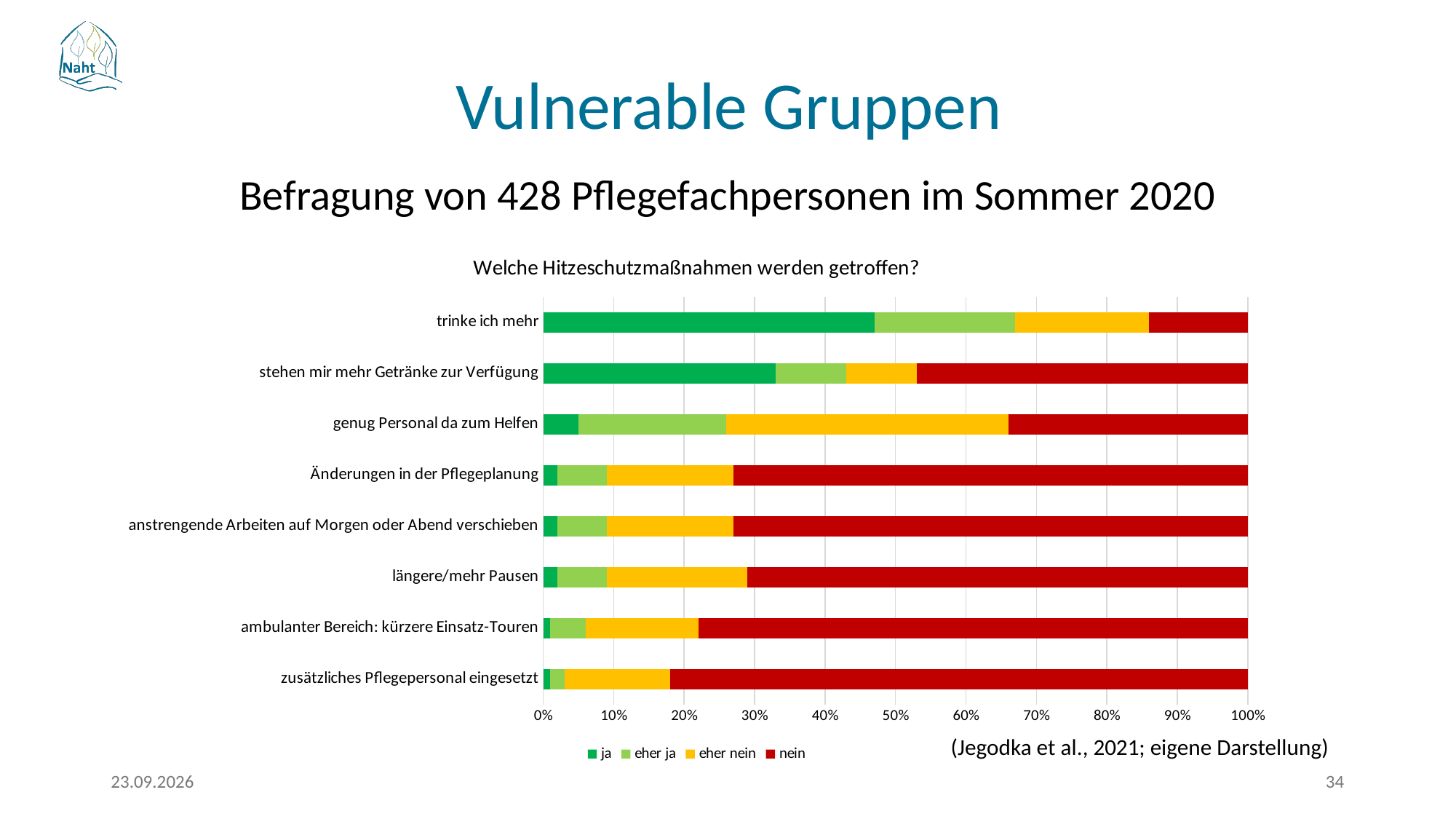
Which measure has the smallest 'nein' share? trinke ich mehr Is the 'ja' share for 'genug Personal da zum Helfen' greater or less than 10%? less Which has the larger 'nein' share: 'genug Personal da zum Helfen' or 'Änderungen in der Pflegeplanung'? Änderungen in der Pflegeplanung Which measure has the largest 'ja' share? trinke ich mehr What is the title of the chart? Welche Hitzeschutzmaßnahmen werden getroffen? What kind of chart is shown on the slide? bar chart How many measures (categories) are listed on the vertical axis of the chart? 8 Is the 'nein' share for 'zusätzliches Pflegepersonal eingesetzt' greater or less than 70%? greater Which entries appear in the chart legend? ja, eher ja, eher nein, nein Is the 'ja' share for 'trinke ich mehr' greater or less than 40%? greater How many series does the chart legend list? 4 Which has the larger 'ja' share: 'trinke ich mehr' or 'stehen mir mehr Getränke zur Verfügung'? trinke ich mehr